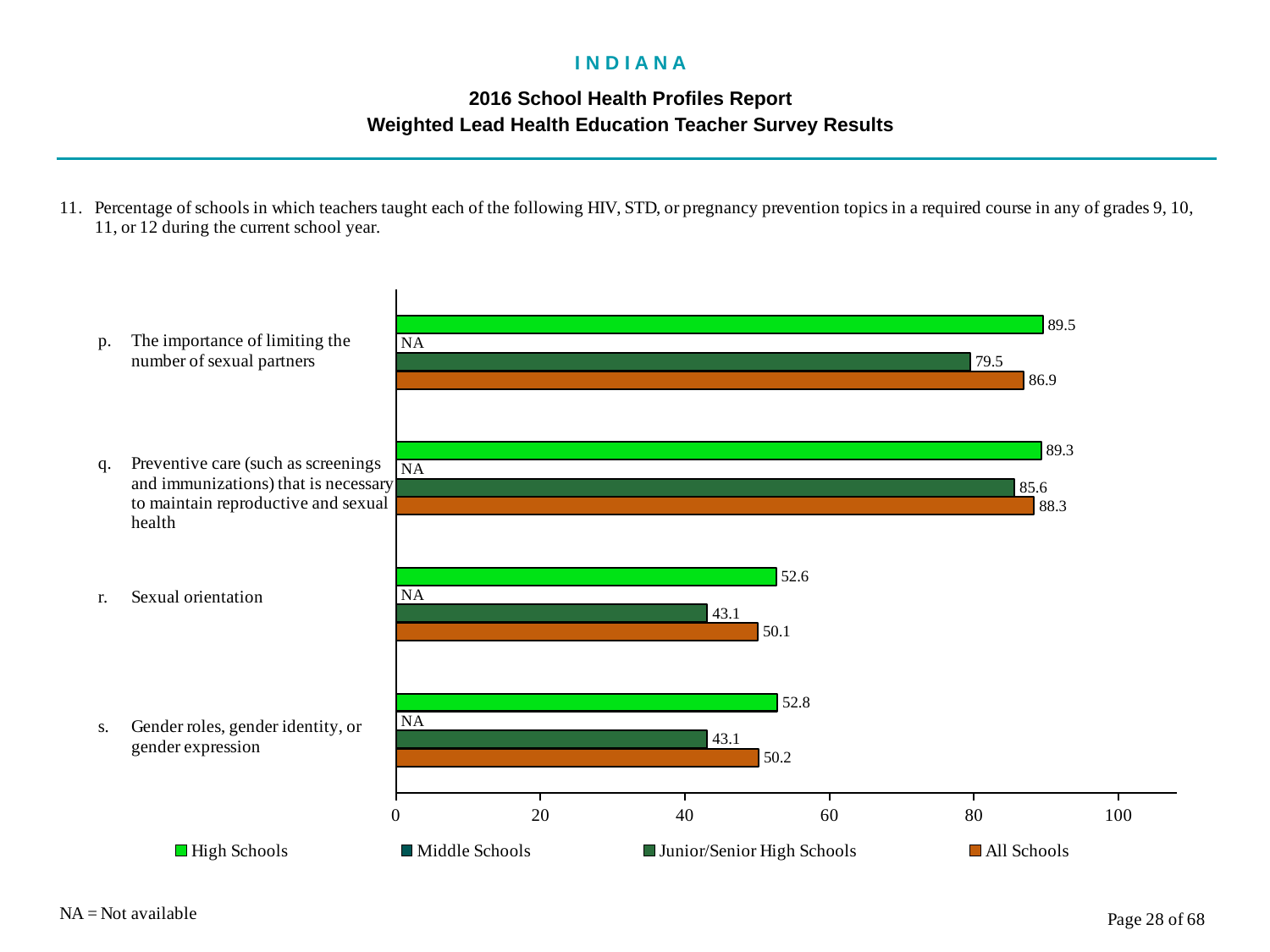
What is the All Schools value for 'Sexual orientation'? 50.1 Which topic has the highest All Schools value? Preventive care (such as screenings and immunizations) that is necessary to maintain reproductive and sexual health What is the Junior/Senior High Schools value for 'Gender roles, gender identity, or gender expression'? 43.1 Is the Junior/Senior High Schools value for 'Preventive care (such as screenings and immunizations) that is necessary to maintain reproductive and sexual health' greater or less than 80? greater What is the difference between the High Schools and Junior/Senior High Schools values for 'The importance of limiting the number of sexual partners'? 10.0 How many series does the legend list? 4 Which topic has the lowest High Schools value? Sexual orientation What kind of chart is shown on the slide? bar chart What is the High Schools value for 'The importance of limiting the number of sexual partners'? 89.5 Which is larger for 'Sexual orientation': the High Schools value or the All Schools value? High Schools How many topics are shown on the chart? 4 What is the Middle Schools value for 'Preventive care (such as screenings and immunizations) that is necessary to maintain reproductive and sexual health'? NA